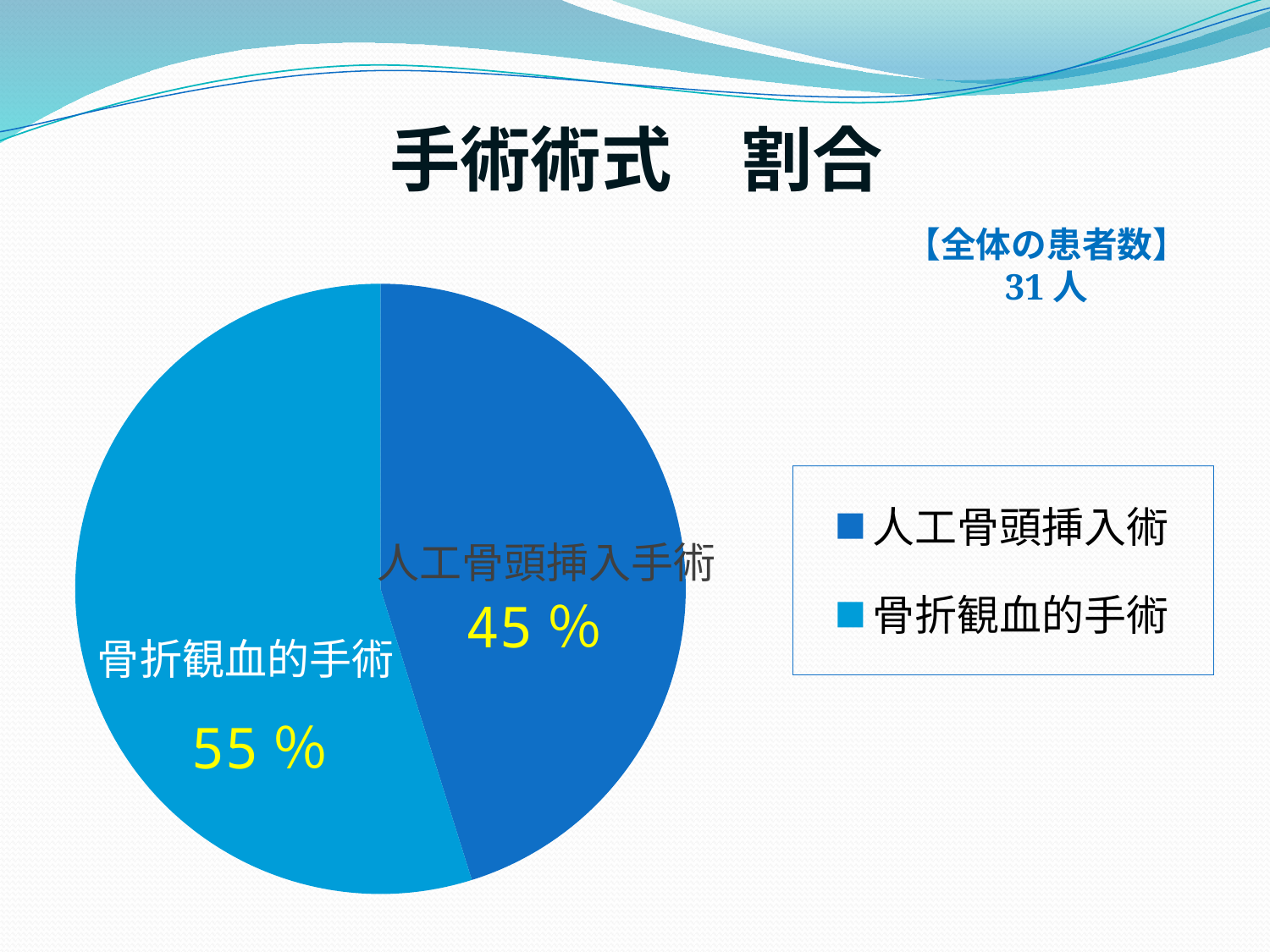
Which slice of the pie is the smallest? 人工骨頭挿入手術 Which slice of the pie is the largest? 骨折観血的手術 What share of the pie does 人工骨頭挿入手術 account for? 45 % What is the title of the slide containing the pie chart? 手術術式 割合 Which is larger, the 人工骨頭挿入手術 slice or the 骨折観血的手術 slice? 骨折観血的手術 What is the difference in percentage points between the 骨折観血的手術 slice and the 人工骨頭挿入手術 slice? 10 % What kind of chart is shown on the slide? pie chart How many slices does the pie chart have? 2 How many entries does the legend list? 2 What is the total number of patients stated on the slide? 31 人 What share of the pie does 骨折観血的手術 account for? 55 %